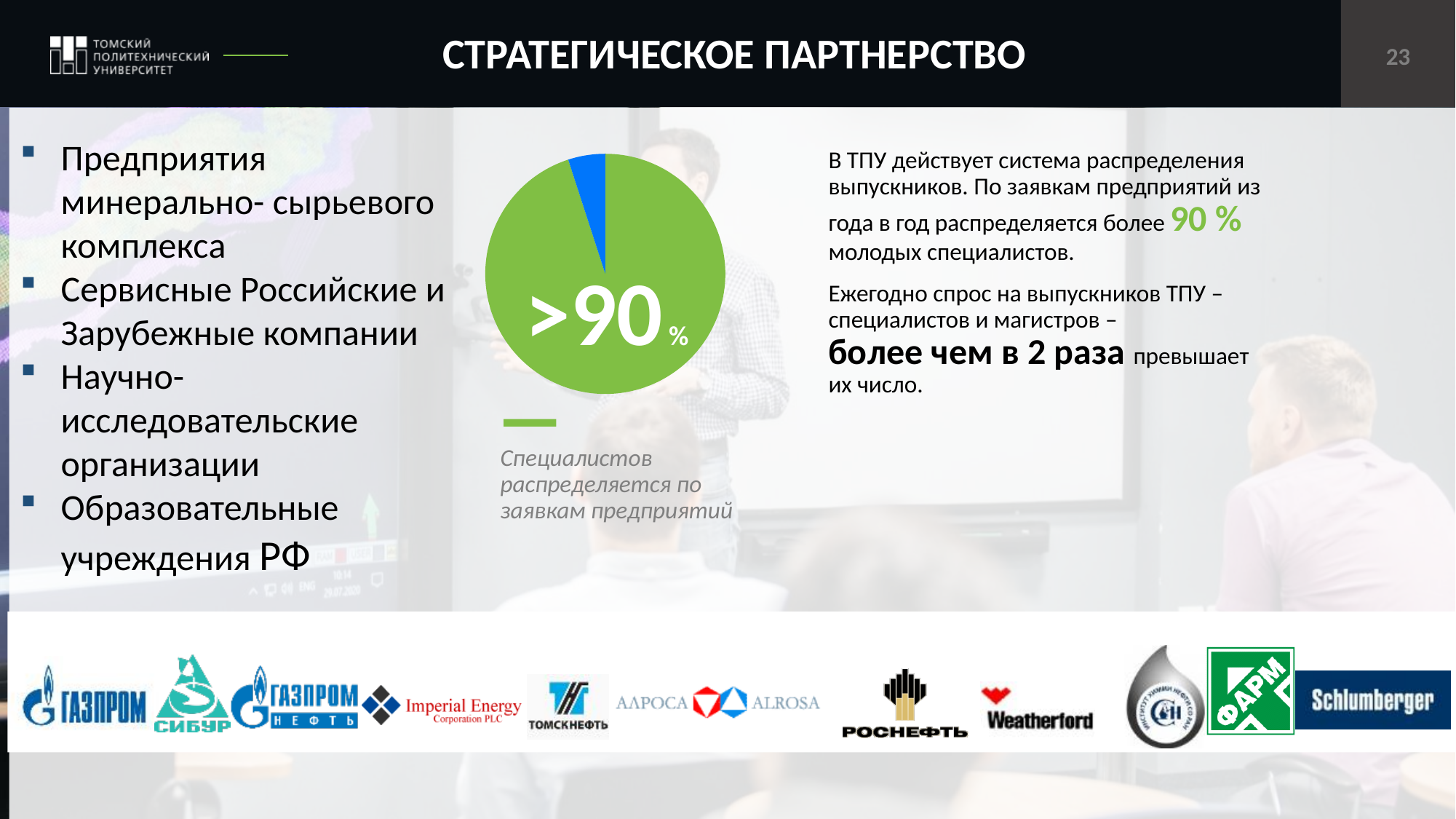
Which slice of the pie chart is larger, the green one or the blue one? the green one How many legend entries are shown for the pie chart? 1 What share of the pie does the green slice (Специалистов распределяется по заявкам предприятий) represent? >90% What kind of chart is shown on the slide? pie chart What colour is the largest slice of the pie chart? green What value is printed on the large green slice of the pie chart? >90% What does the legend entry below the pie chart say? Специалистов распределяется по заявкам предприятий How many slices does the pie chart have? 2